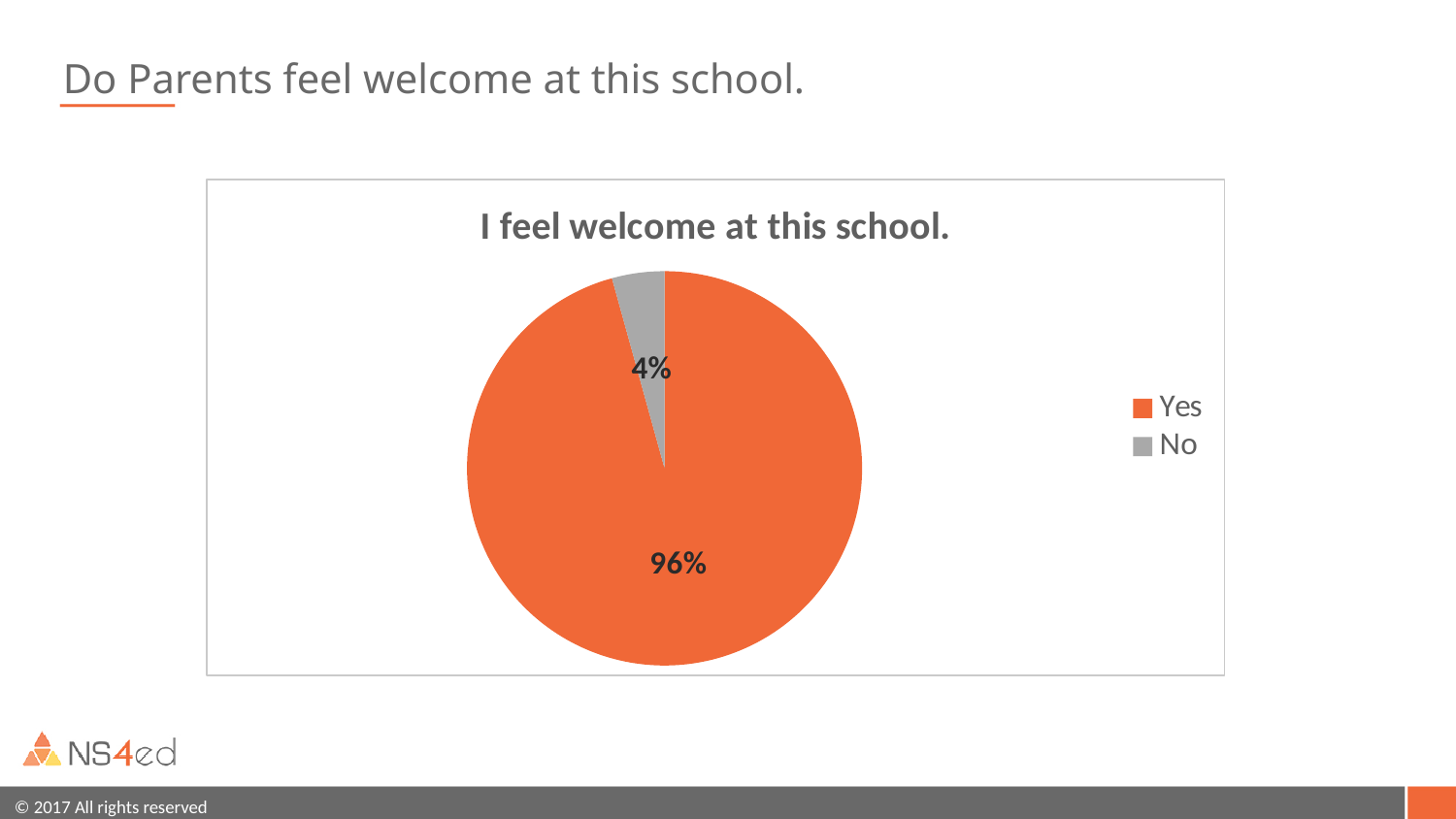
What share of the pie does the "No" slice represent? 4% What percentage of the pie is labelled "No"? 4% What is the difference in percentage points between the "Yes" and "No" slices? 92 Which slice of the pie is the largest? Yes What kind of chart is shown on the slide? pie chart What is the title of the chart? I feel welcome at this school. How many slices does the pie chart have? 2 How many entries does the legend list? 2 What percentage of the pie is labelled "Yes"? 96% Which is larger, the "Yes" slice or the "No" slice? Yes Which slice of the pie is the smallest? No What colour is the "Yes" slice? orange